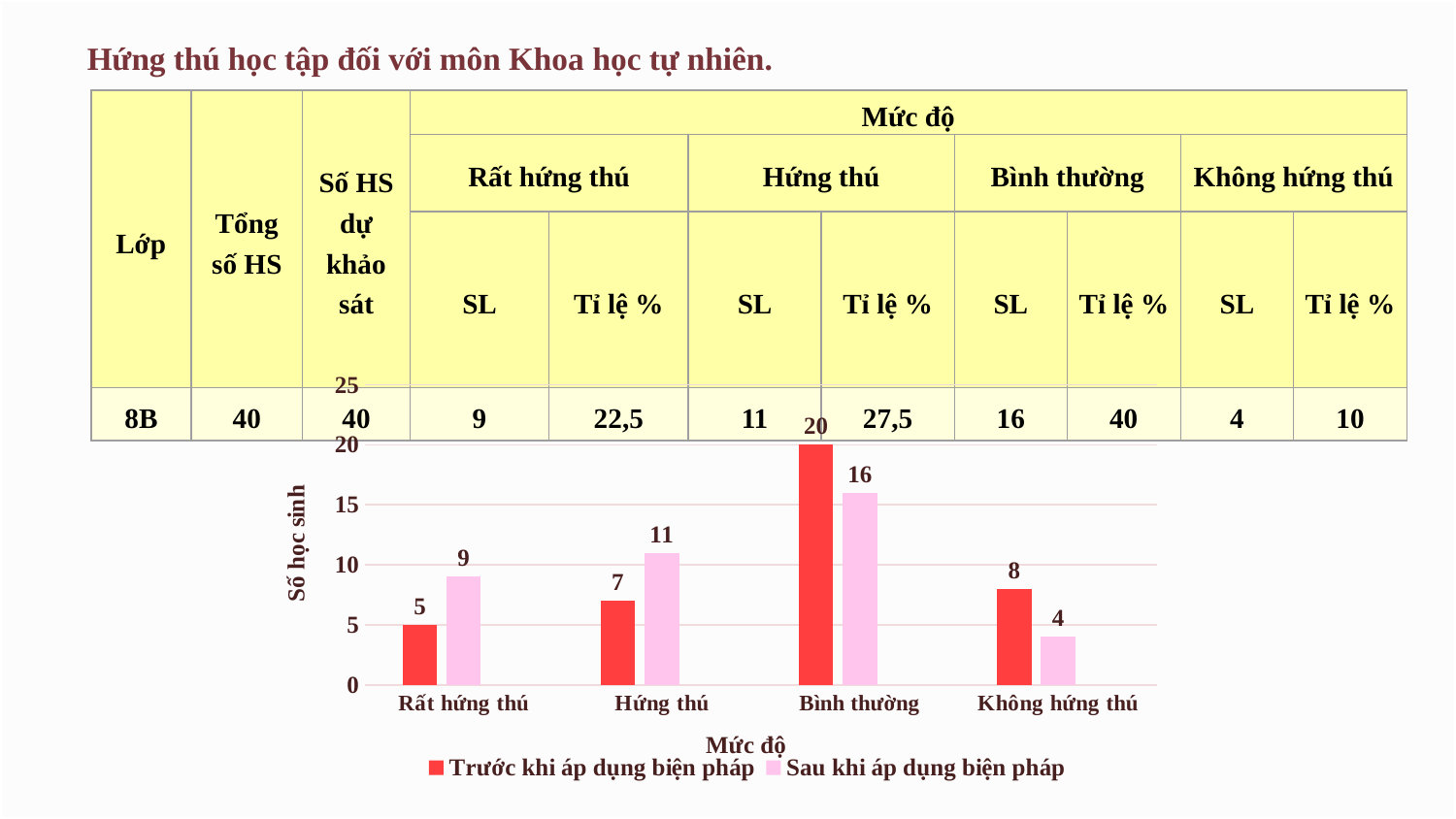
What type of chart is shown on the slide? bar chart What is the label of the vertical axis of the chart? Số học sinh What is the value for Hứng thú in the Sau khi áp dụng biện pháp series? 11 What is the value for Bình thường in the Trước khi áp dụng biện pháp series? 20 For Không hứng thú, which series has the larger value: Trước khi áp dụng biện pháp or Sau khi áp dụng biện pháp? Trước khi áp dụng biện pháp Which category has the lowest value in the Sau khi áp dụng biện pháp series? Không hứng thú Which category has the highest value in the Trước khi áp dụng biện pháp series? Bình thường What is the value for Không hứng thú in the Sau khi áp dụng biện pháp series? 4 What is the difference between the Trước khi áp dụng biện pháp and Sau khi áp dụng biện pháp values for Rất hứng thú? 4 How many categories are shown on the x axis of the chart? 4 How many series does the chart legend list? 2 Is the value for Bình thường in the Sau khi áp dụng biện pháp series greater or less than 15? greater